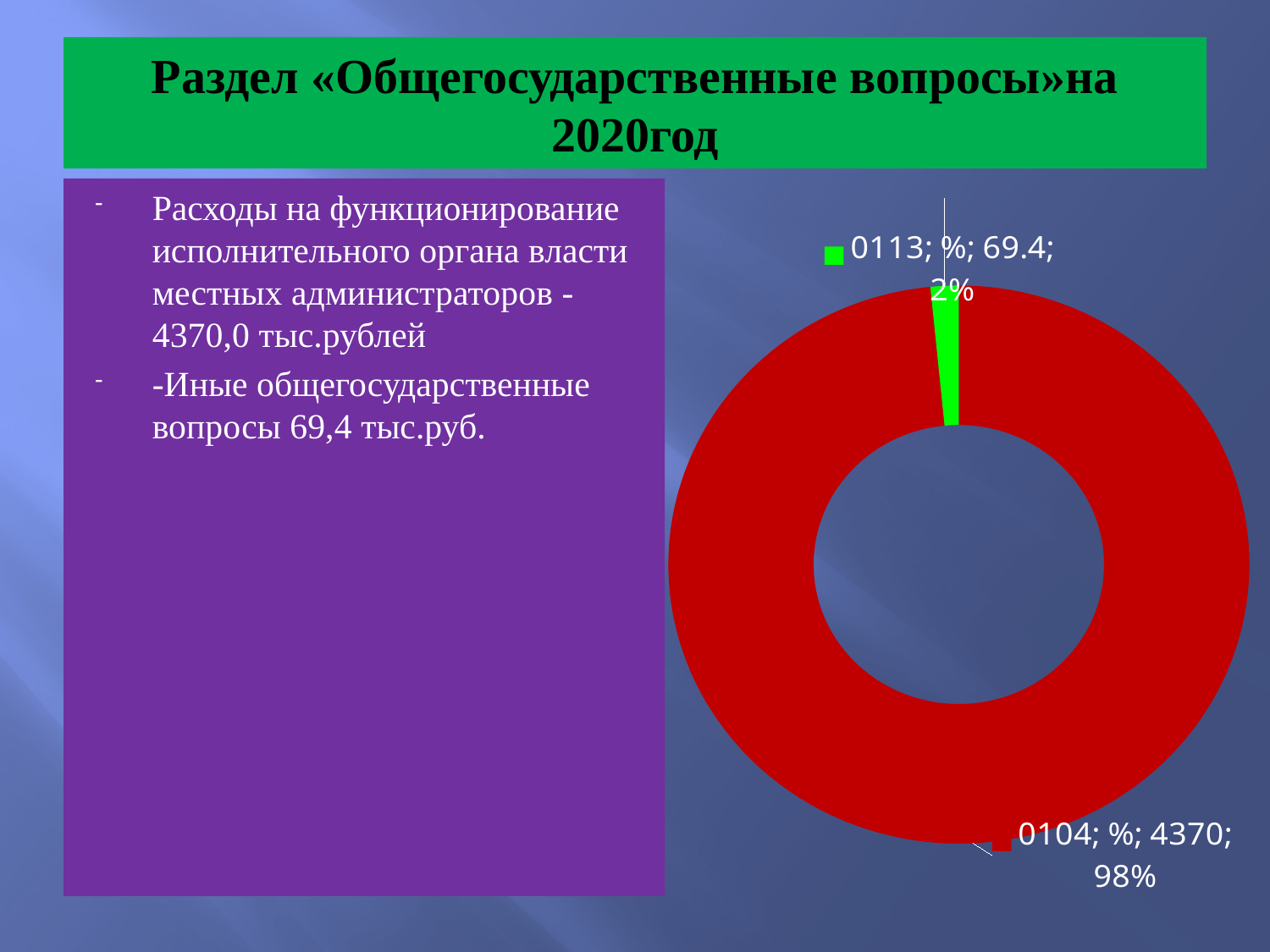
What share of the chart does category 0113 represent? 2% Which is larger, the value for 0104 or the value for 0113? 0104 What share of the chart does category 0104 represent? 98% What colour is the slice for category 0104? Red What value is shown for category 0104? 4370 What colour is the slice for category 0113? Green Which category has the smallest slice? 0113 What kind of chart is shown on the slide? Doughnut (pie) chart What value is shown for category 0113? 69.4 How many slices does the chart have? 2 Which category has the largest slice? 0104 What is the difference between the values for 0104 and 0113? 4300.6